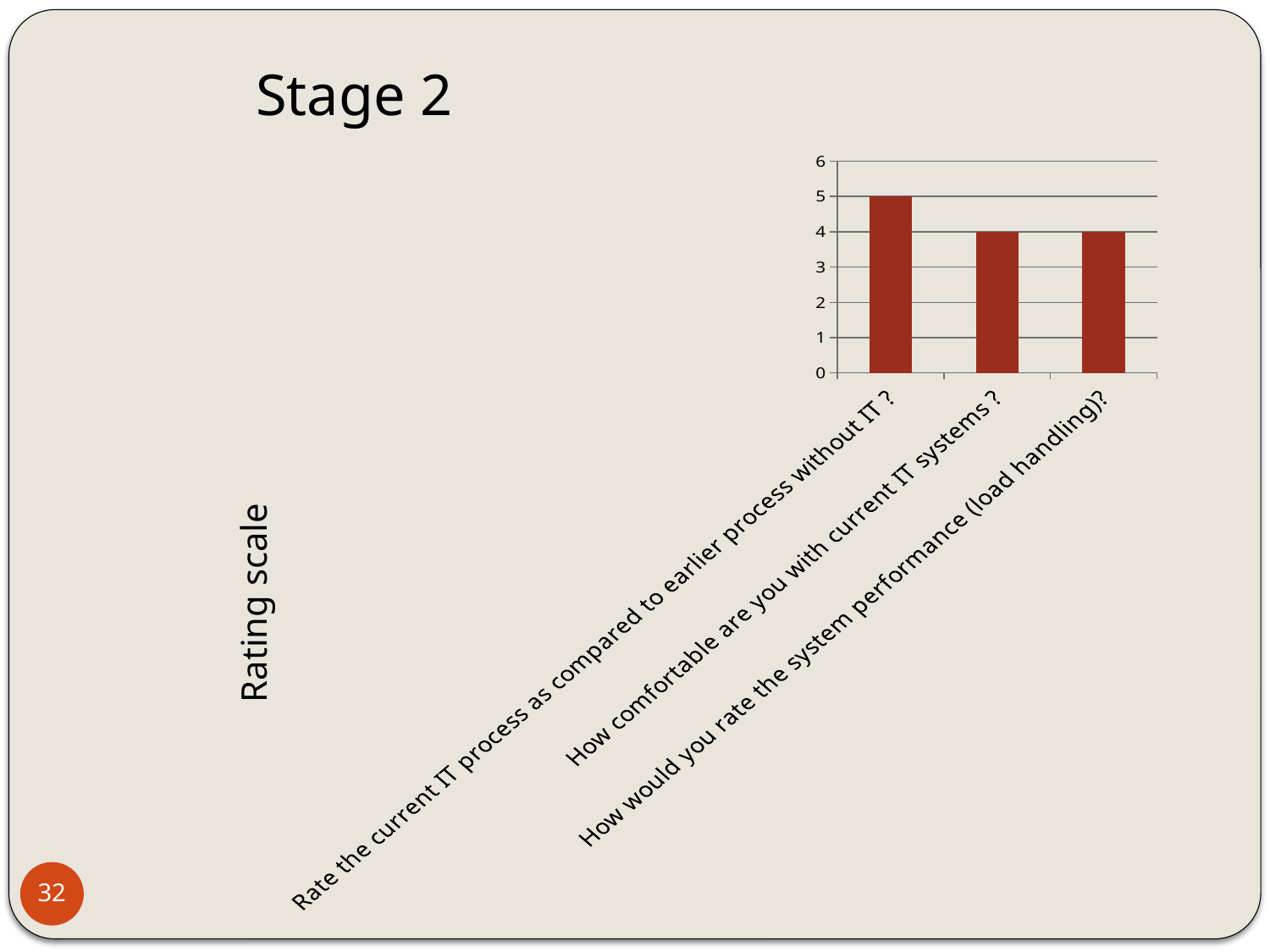
Which is larger: the value for "Rate the current IT process as compared to earlier process without IT ?" or the value for "How would you rate the system performance (load handling)?"? Rate the current IT process as compared to earlier process without IT ? Is the value for "How comfortable are you with current IT systems ?" greater or less than 5? less What is the highest value shown on the vertical axis? 6 What kind of chart is shown on the slide? bar chart What is the value for "Rate the current IT process as compared to earlier process without IT ?"? 5 How many bars does the chart show? 3 What is the label on the vertical axis of the chart? Rating scale Is the value for "Rate the current IT process as compared to earlier process without IT ?" greater or less than 3? greater What is the value for "How comfortable are you with current IT systems ?"? 4 Which category has the highest value? Rate the current IT process as compared to earlier process without IT ? What is the value for "How would you rate the system performance (load handling)?"? 4 What is the difference between the value for "Rate the current IT process as compared to earlier process without IT ?" and the value for "How comfortable are you with current IT systems ?"? 1